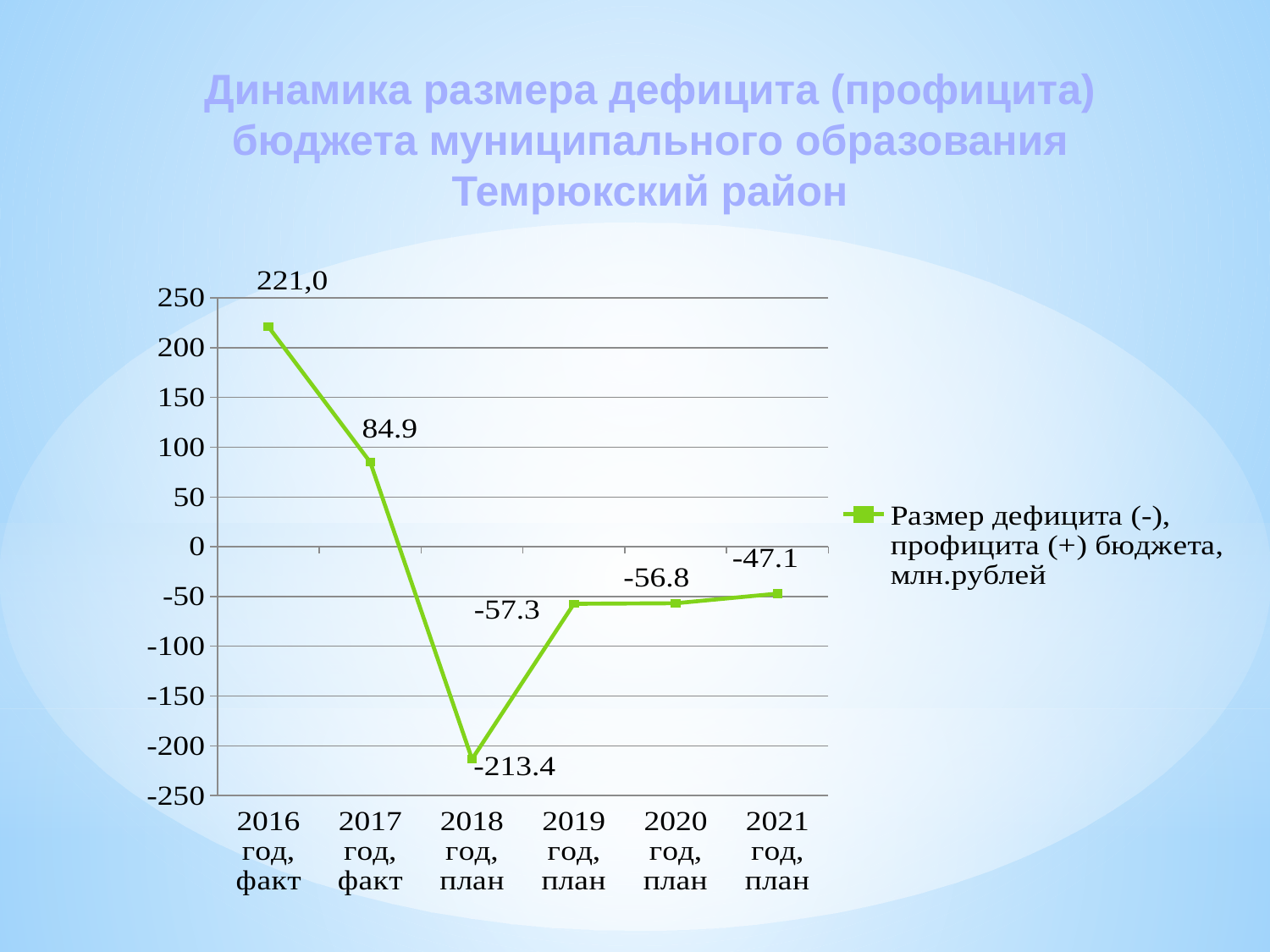
What is the value for 2021 год, план? -47.1 Which is larger, the value for 2017 год, факт or the value for 2019 год, план? 2017 год, факт What kind of chart is shown on the slide? line chart What is the value for 2018 год, план? -213.4 From 2016 год, факт to 2018 год, план, does the value rise or fall? fall What is the difference between the values for 2017 год, факт and 2018 год, план? 298.3 What is the value for 2020 год, план? -56.8 What is the difference between the values for 2021 год, план and 2020 год, план? 9.7 What is the value for 2016 год, факт? 221,0 Which year has the lowest value? 2018 год, план How many data points are plotted on the chart? 6 Which year has the highest value? 2016 год, факт